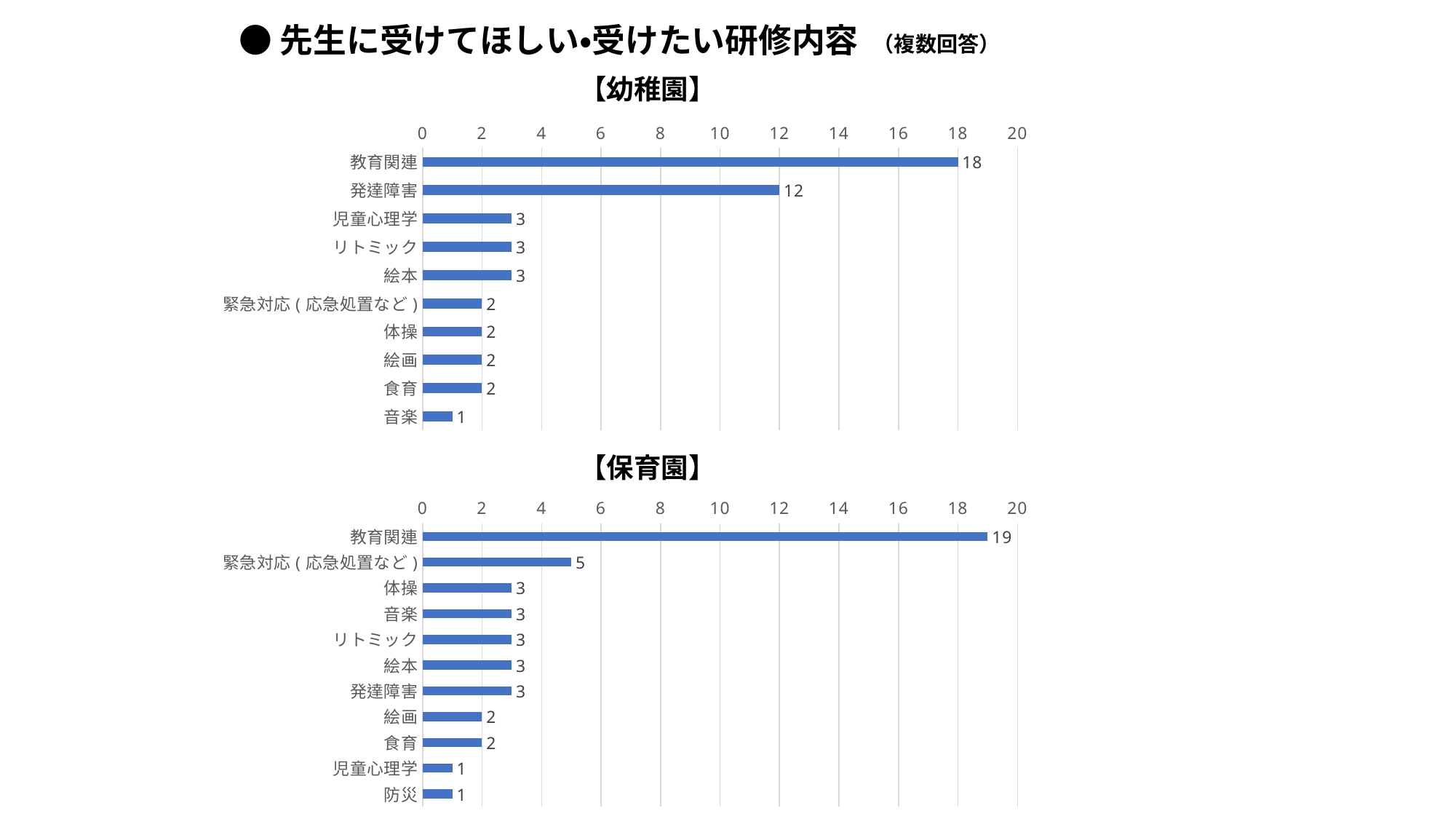
In the 【保育園】 chart, which category has the highest value? 教育関連 In the 【幼稚園】 chart, which category has the lowest value? 音楽 In the 【幼稚園】 chart, which category has the highest value? 教育関連 In the 【幼稚園】 chart, how many categories are shown? 10 In the 【幼稚園】 chart, what is the difference between 教育関連 and 発達障害? 6 In the 【保育園】 chart, what is the value for 緊急対応 ( 応急処置など )? 5 In the 【幼稚園】 chart, what is the value for 発達障害? 12 In the 【保育園】 chart, how many categories are shown? 11 In the 【幼稚園】 chart, is the value for 教育関連 greater or less than 16? greater In the 【保育園】 chart, what is the difference between 教育関連 and 緊急対応 ( 応急処置など )? 14 Which is larger: 発達障害 in the 【幼稚園】 chart or 発達障害 in the 【保育園】 chart? 【幼稚園】 What type of chart is the 【保育園】 chart? bar chart